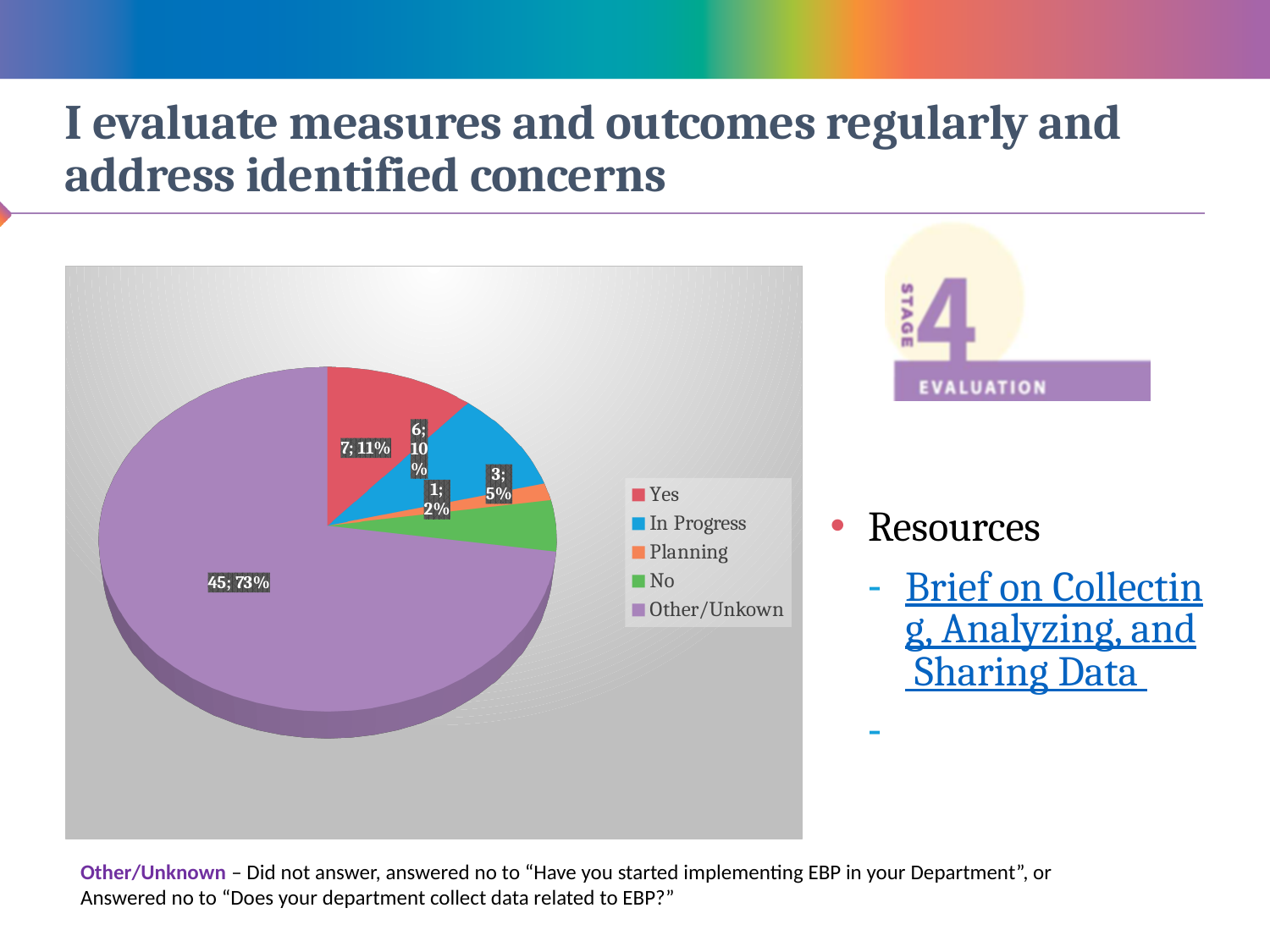
What is the data label shown for the Yes slice? 7; 11% Which category has the smallest slice of the pie? Planning Which category has the largest slice of the pie? Other/Unkown How many categories does the pie chart show? 5 What is the difference between the count for Other/Unkown and the count for Yes? 38 What percentage share of the pie does the Yes slice represent? 11% Which has a larger count, Yes or In Progress? Yes What kind of chart is shown on the slide? pie chart What is the data label shown for the In Progress slice? 6; 10% What colour is the Other/Unkown slice in the pie chart? purple What is the data label shown for the Other/Unkown slice? 45; 73% What is the total count across all slices of the pie? 62